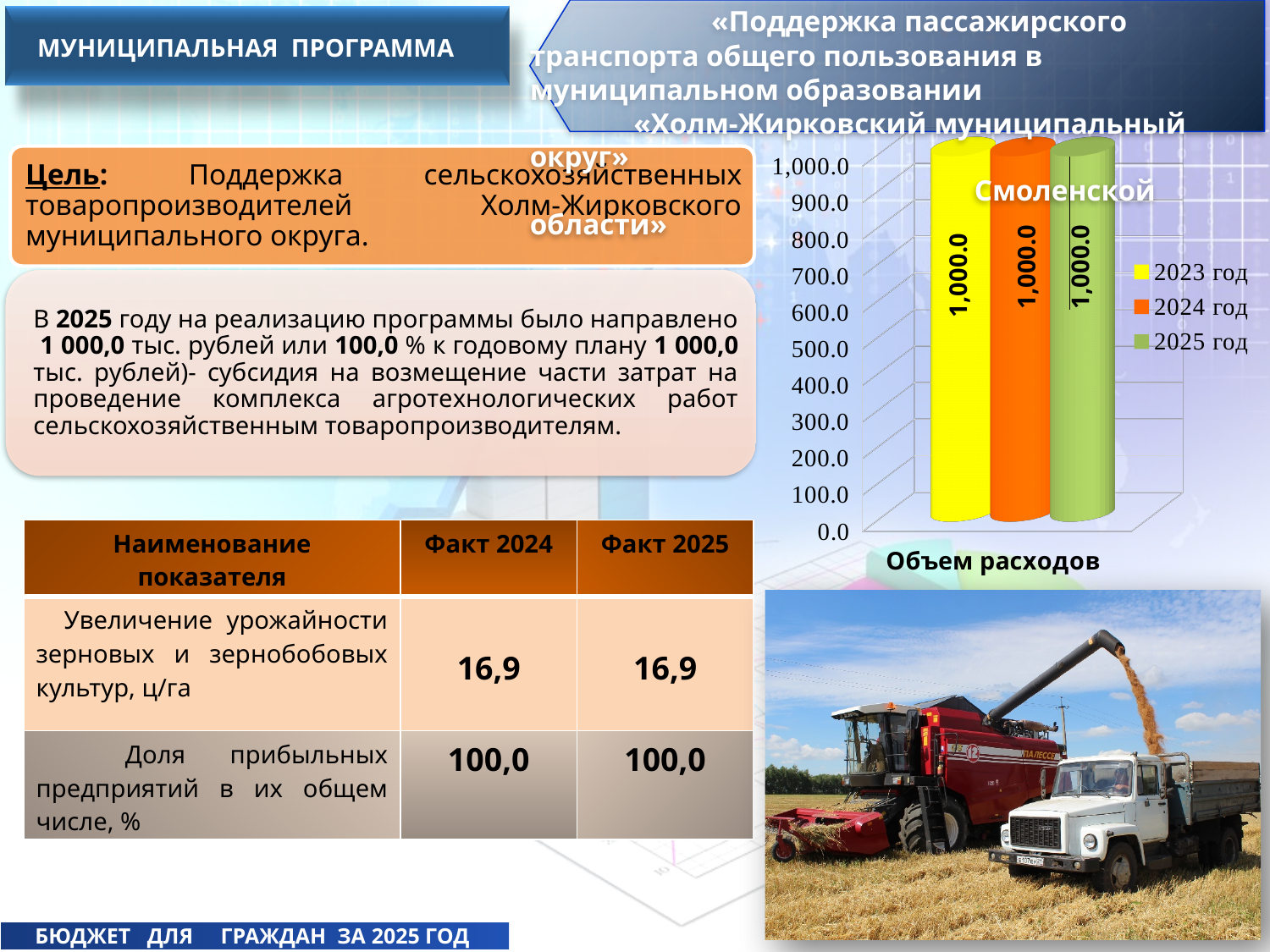
What is the value for 2024 год in the Объем расходов chart? 1,000.0 Which colour represents 2025 год in the legend of the Объем расходов chart? green What is the value for 2025 год in the Объем расходов chart? 1,000.0 How many series does the legend of the Объем расходов chart list? 3 How many bars are plotted in the Объем расходов chart? 3 What kind of chart is the Объем расходов chart? bar chart What is the value for 2023 год in the Объем расходов chart? 1,000.0 What is the highest tick shown on the vertical axis of the Объем расходов chart? 1,000.0 Is the value for 2024 год in the Объем расходов chart greater or less than 500.0? greater What is the difference between the values for 2025 год and 2024 год in the Объем расходов chart? 0.0 Do the values in the Объем расходов chart rise, fall or stay the same from 2023 год to 2025 год? stay the same